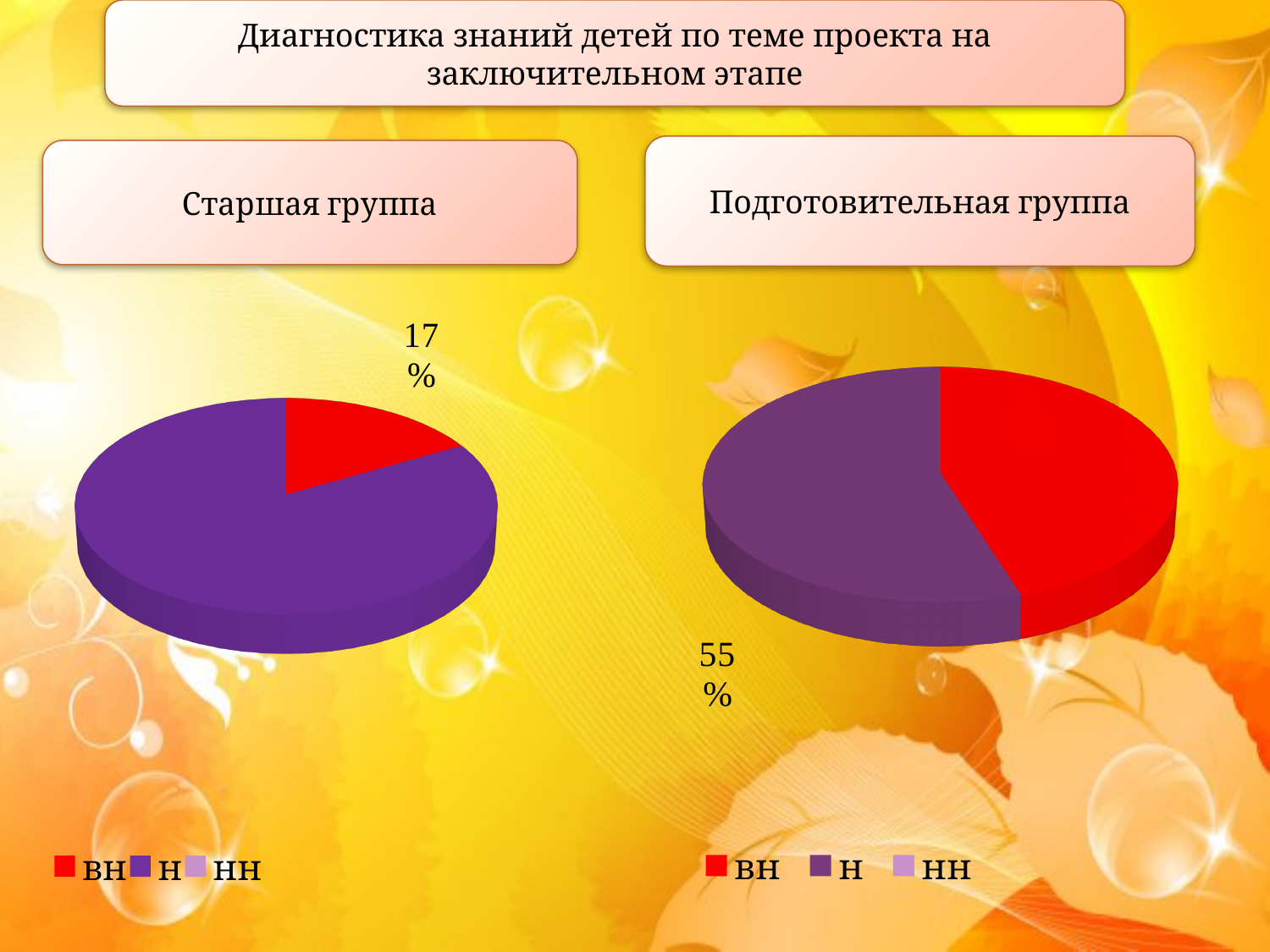
In the Подготовительная группа chart, which is larger, Н or ВН? Н In the Старшая группа chart, which category has the largest slice? Н In the Старшая группа chart, which visible slice is the smallest? ВН What are the legend entries of the Подготовительная группа chart? ВН, Н, НН What kind of chart is used for the Старшая группа? pie chart What colour represents ВН in the legend of the Старшая группа chart? red How many entries does the legend of the Старшая группа chart list? 3 How many slices are visible in the Подготовительная группа pie? 2 In the Подготовительная группа chart, which category has the largest slice? Н In the Старшая группа chart, what share does ВН have? 17% How many charts are on the slide? 2 In the Подготовительная группа chart, what share does Н have? 55%